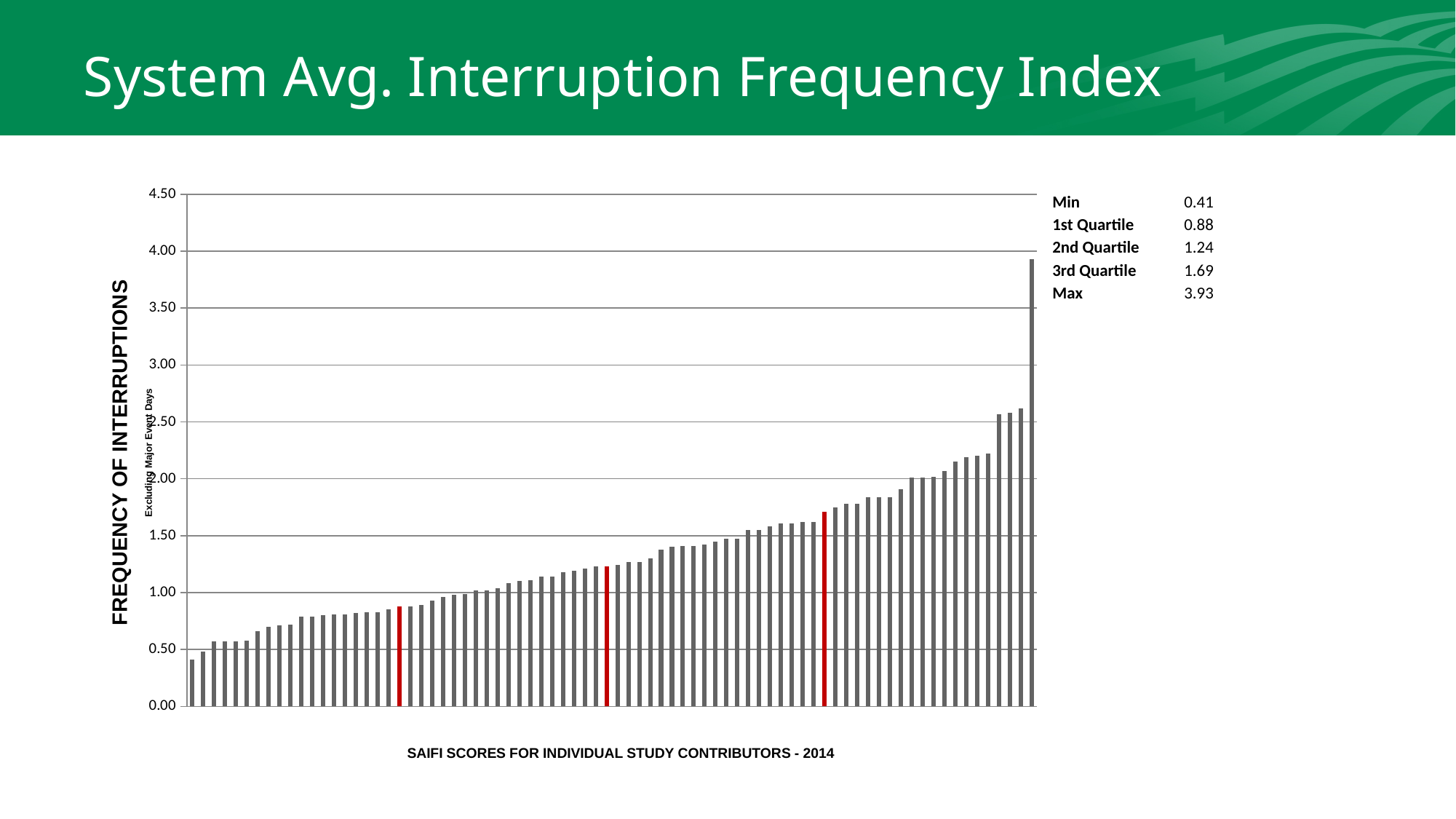
What is the 2nd Quartile value listed on the chart? 1.24 Is the value of the tallest bar greater or less than 3.50? greater Is the value of the leftmost (shortest) bar greater or less than 0.50? less What is the Min value listed in the summary table on the chart? 0.41 Do the bar values rise or fall from left to right along the x axis? rise What is the 1st Quartile value listed on the chart? 0.88 What is the x-axis title of the chart? SAIFI SCORES FOR INDIVIDUAL STUDY CONTRIBUTORS - 2014 What is the 3rd Quartile value listed on the chart? 1.69 What is the difference between the Max and Min values listed on the chart? 3.52 What is the Max value listed in the summary table on the chart? 3.93 What kind of chart is shown on the slide? bar chart How many bars are highlighted in red on the chart? 3